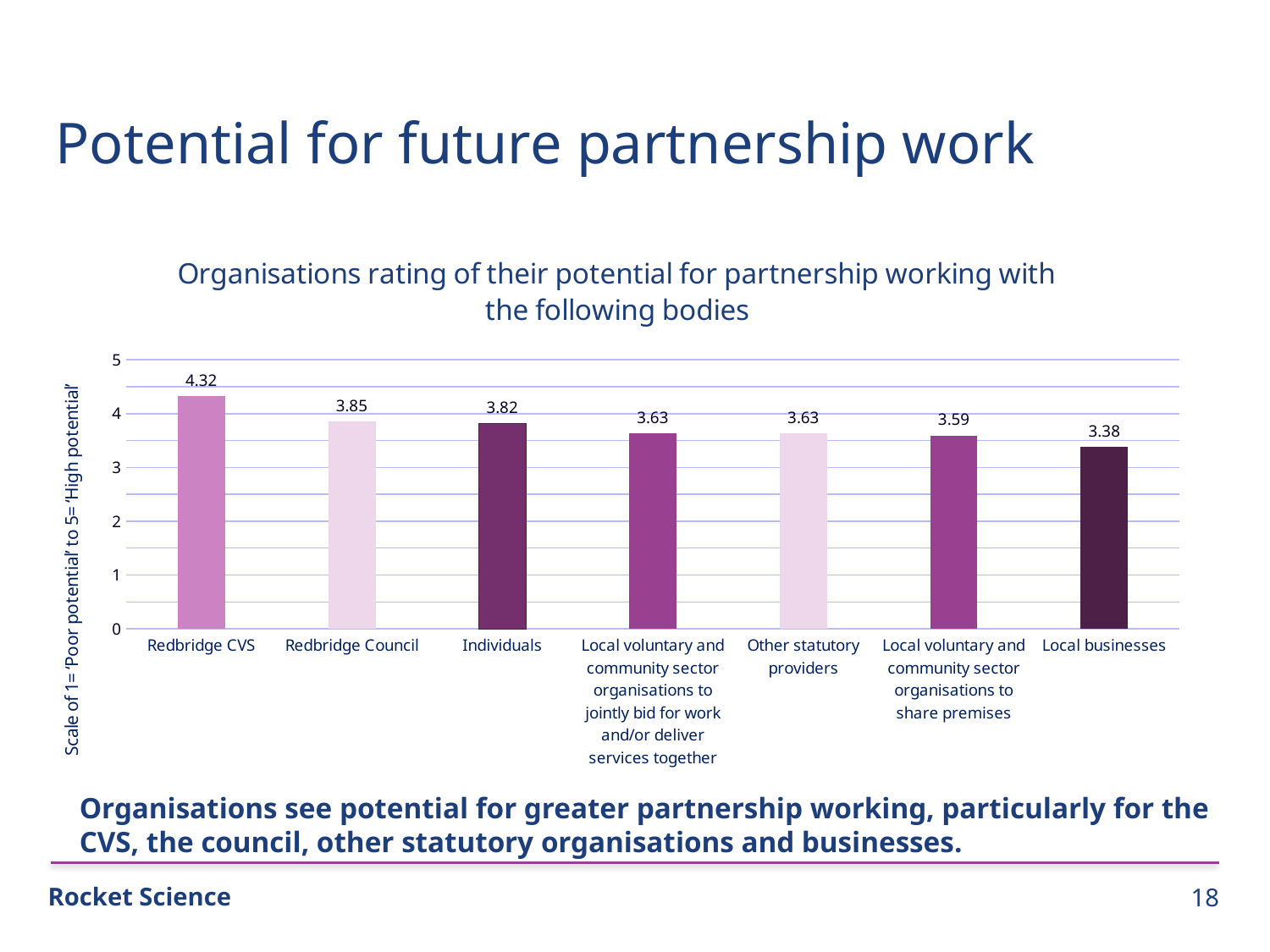
What is the rating for Local businesses? 3.38 What is the rating for Redbridge CVS? 4.32 Which has a higher rating, Redbridge Council or Local voluntary and community sector organisations to share premises? Redbridge Council What is the rating for Individuals? 3.82 Which body has the highest rating? Redbridge CVS How many bodies are shown on the chart? 7 What kind of chart is shown on the slide? Bar chart What is the title of the chart? Organisations rating of their potential for partnership working with the following bodies What is the difference between the ratings for Redbridge CVS and Redbridge Council? 0.47 Which body has the lowest rating? Local businesses What is the rating for Other statutory providers? 3.63 What is the difference between the ratings for Redbridge Council and Local businesses? 0.47